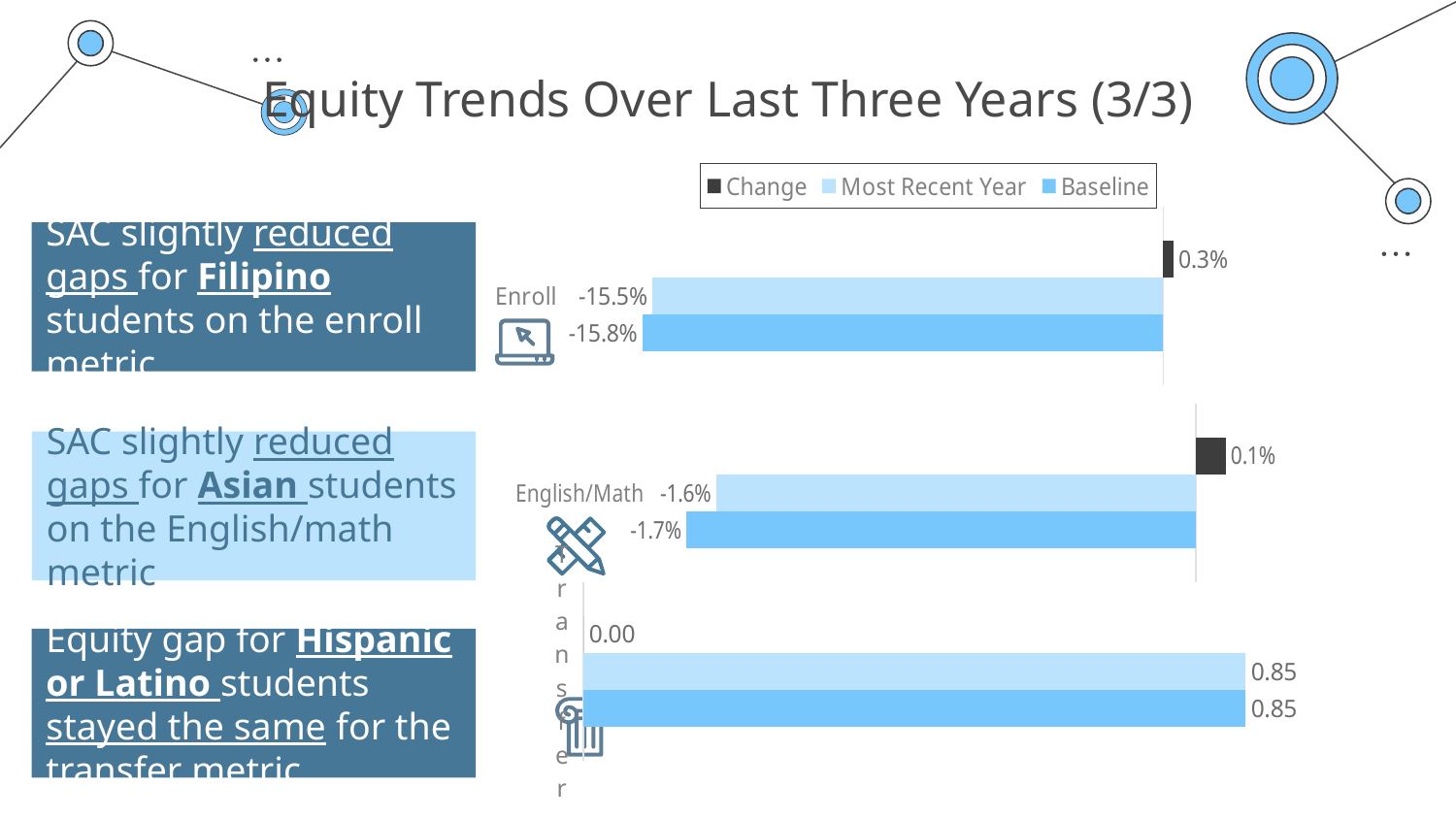
What kind of chart is used on this slide? Bar chart In the English/Math chart, what is the Change value? 0.1% In the bottom chart, what is the Change value? 0.00 In the English/Math chart, what is the Baseline value? -1.7% In the English/Math chart, what is the Most Recent Year value? -1.6% In the Enroll chart, what is the Baseline value? -15.8% In the Enroll chart, which is larger, the Most Recent Year value or the Baseline value? Most Recent Year How many series does the legend list? 3 In the Enroll chart, what is the value for Most Recent Year? -15.5% In the Enroll chart, what is the value of the Change bar? 0.3% Which legend entry is shown in dark grey? Change In the bottom chart, what is the Baseline value? 0.85